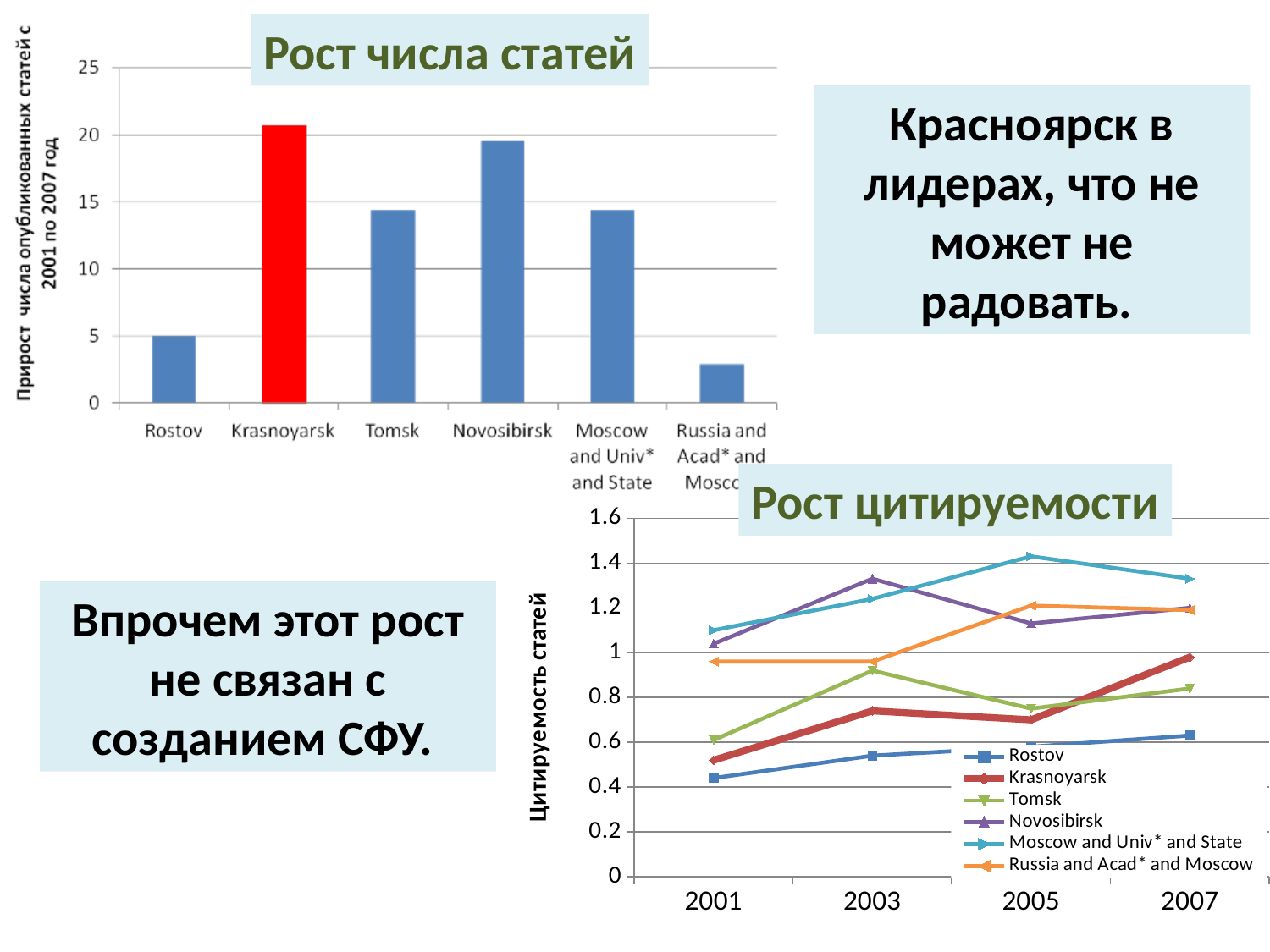
What kind of chart is the chart titled "Рост числа статей"? bar chart In the chart titled "Рост числа статей", which is larger: the value for Novosibirsk or the value for Tomsk? Novosibirsk In the chart titled "Рост цитируемости", does the Rostov series rise or fall from 2001 to 2007? rises In the chart titled "Рост числа статей", how many categories are shown on the x axis? 6 In the chart titled "Рост цитируемости", how many series does the legend list? 6 In the chart titled "Рост числа статей", is the value for Krasnoyarsk greater or less than 20? greater In the chart titled "Рост числа статей", what colour is the bar for Krasnoyarsk? red In the chart titled "Рост числа статей", is the value for Russia and Acad* and Moscow greater or less than 5? less What kind of chart is the chart titled "Рост цитируемости"? line chart In the chart titled "Рост цитируемости", which series has the highest value in 2005? Moscow and Univ* and State In the chart titled "Рост числа статей", which category has the highest value? Krasnoyarsk In the chart titled "Рост числа статей", which category has the lowest value? Russia and Acad* and Moscow